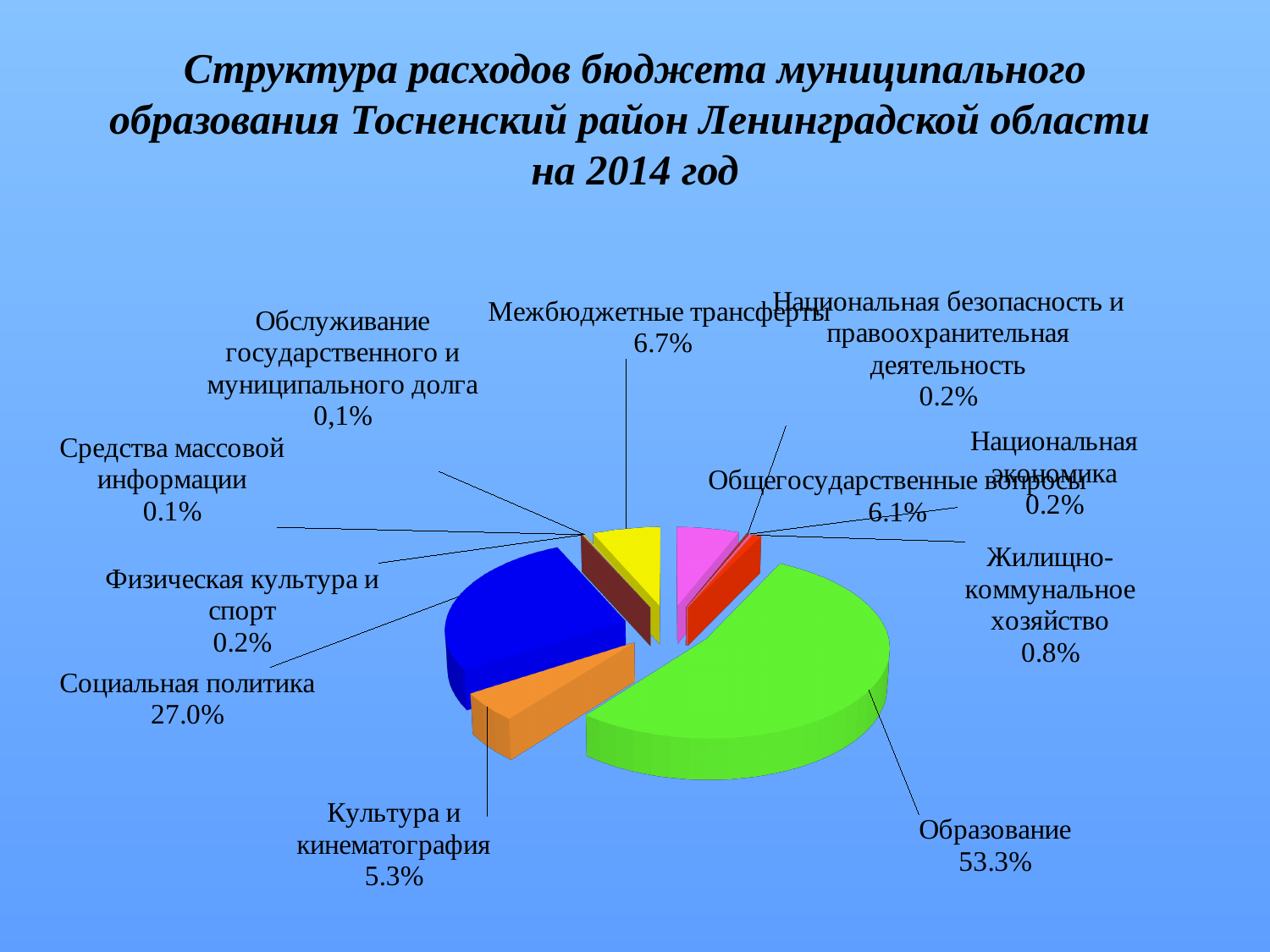
What is the value for Межбюджетные трансферты? 6.7% What is the difference in percentage points between Общегосударственные вопросы and Культура и кинематография? 0.8 What share of the budget expenditure goes to Образование? 53.3% Which category has the largest share of the budget expenditure? Образование How many categories are shown in the pie chart? 11 Which is larger, Межбюджетные трансферты or Общегосударственные вопросы? Межбюджетные трансферты What is the value for Культура и кинематография? 5.3% What is the difference in percentage points between Образование and Социальная политика? 26.3 What colour is the slice for Образование? Green What type of chart is shown on the slide? Pie chart What is the value for Социальная политика? 27.0% What is the value for Жилищно-коммунальное хозяйство? 0.8%